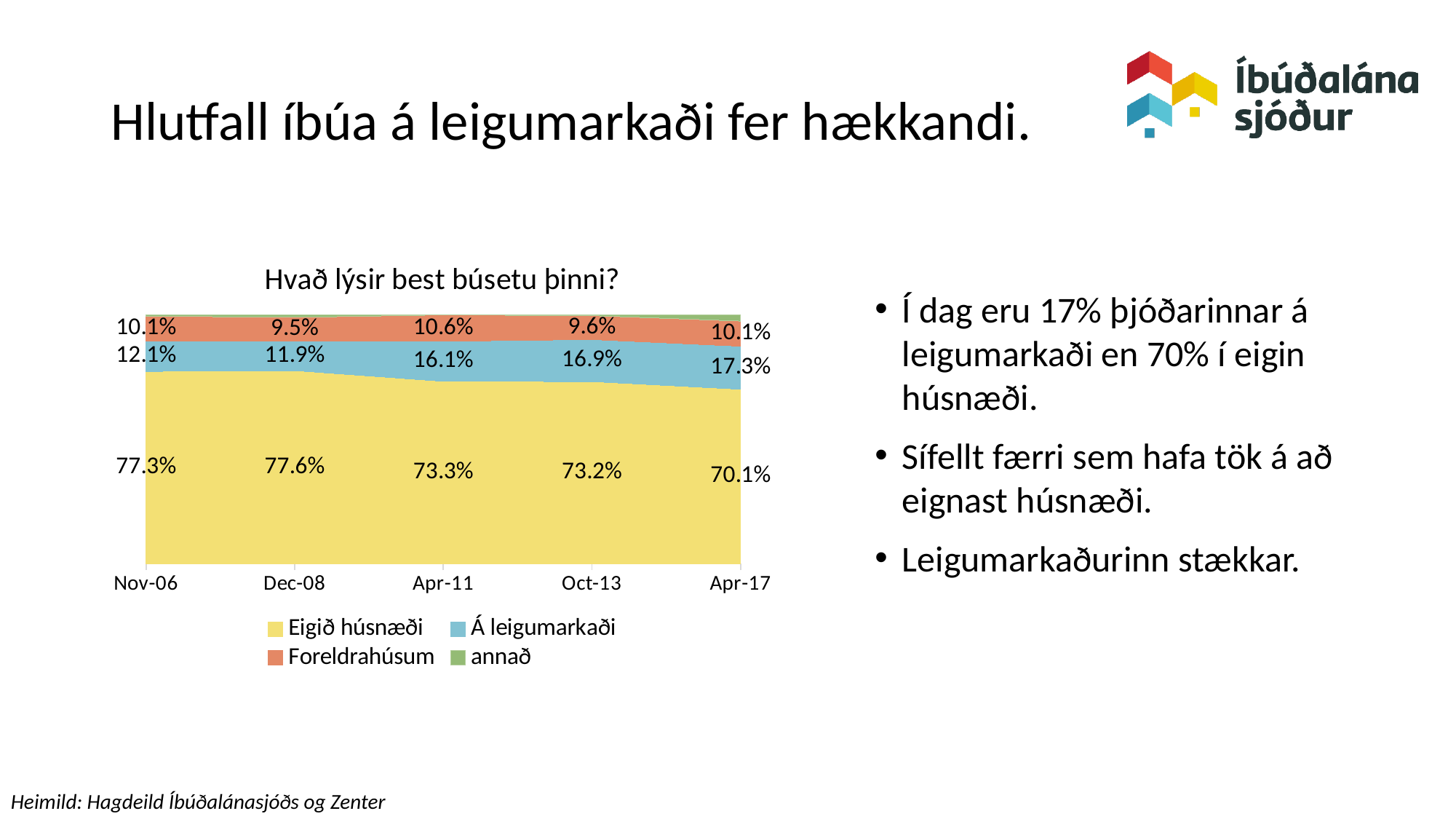
Which is larger: Á leigumarkaði at Apr-11 or Foreldrahúsum at Apr-11? Á leigumarkaði at Apr-11 What is the value for Á leigumarkaði at Apr-17? 17.3% Does the value for Á leigumarkaði rise or fall from Nov-06 to Apr-17? Rise What is the difference between the Eigið húsnæði values at Nov-06 and Apr-17? 7.2% What is the value for Á leigumarkaði at Oct-13? 16.9% What type of chart is shown on the slide? Stacked area chart At which time point is Á leigumarkaði lowest? Dec-08 What is the value for Eigið húsnæði at Nov-06? 77.3% How many time points are shown on the x axis? 5 How many series does the legend list? 4 What is the value for Foreldrahúsum at Apr-11? 10.6% At which time point is Eigið húsnæði highest? Dec-08